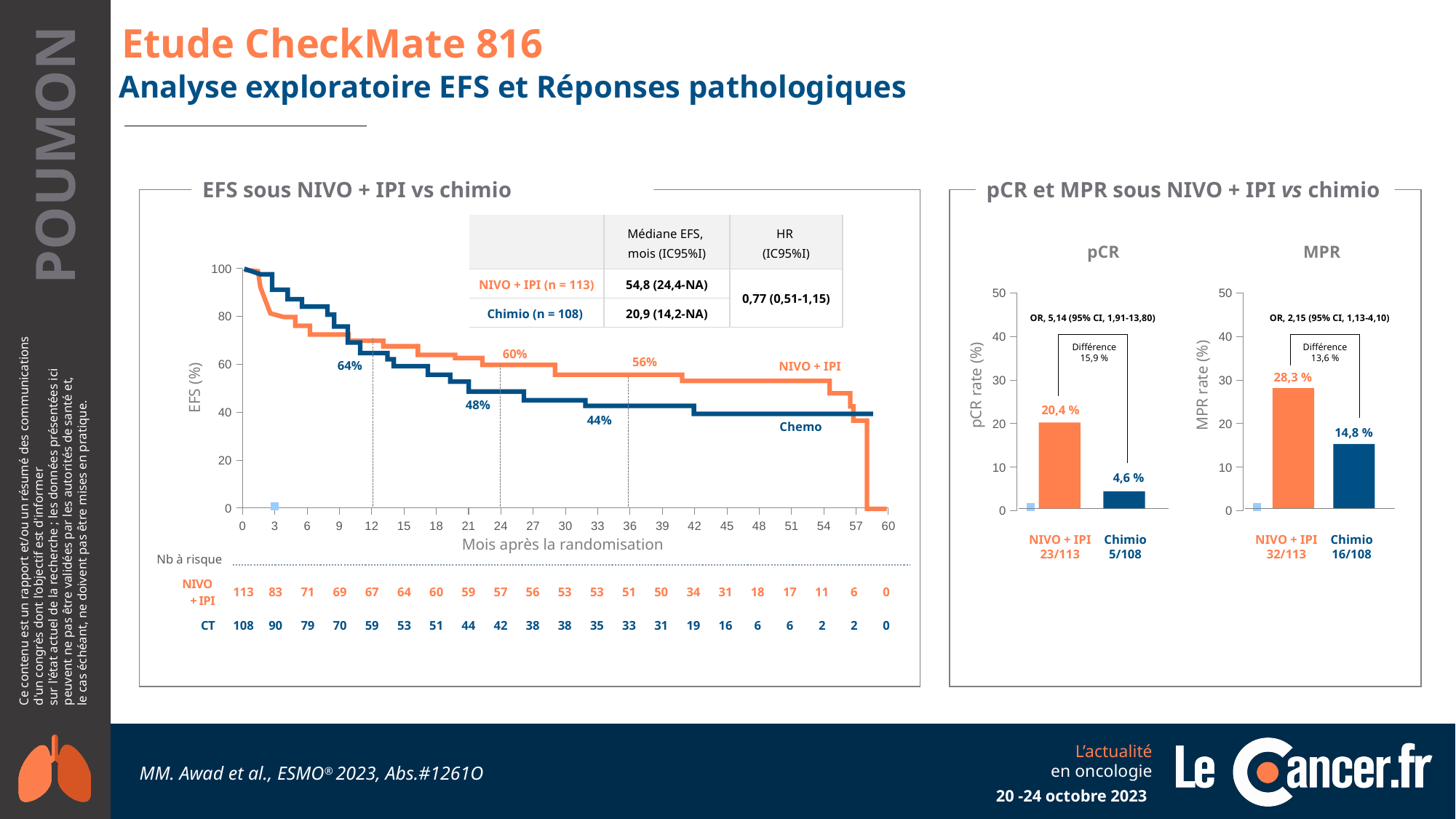
In the MPR chart, is the value for Chimio greater or less than 20? less In the MPR chart, what is the MPR rate for Chimio? 14,8 % What kind of chart is used for the pCR and MPR panels? Bar chart In the MPR chart, which arm has the higher MPR rate? NIVO + IPI In the pCR chart, what is the pCR rate for Chimio? 4,6 % In the pCR chart, what is the pCR rate for NIVO + IPI? 20,4 % In the MPR chart, what is the MPR rate for NIVO + IPI? 28,3 % In the EFS chart, how many NIVO + IPI patients were at risk at 12 months? 67 In the EFS chart, what is the median EFS in months for the Chimio arm? 20,9 (14,2-NA) In the EFS chart, what is the EFS rate for Chemo at 36 months? 44% In the EFS chart, what is the EFS rate for NIVO + IPI at 24 months? 60% In the pCR chart, what is the difference between the NIVO + IPI and Chimio pCR rates? 15,9 %